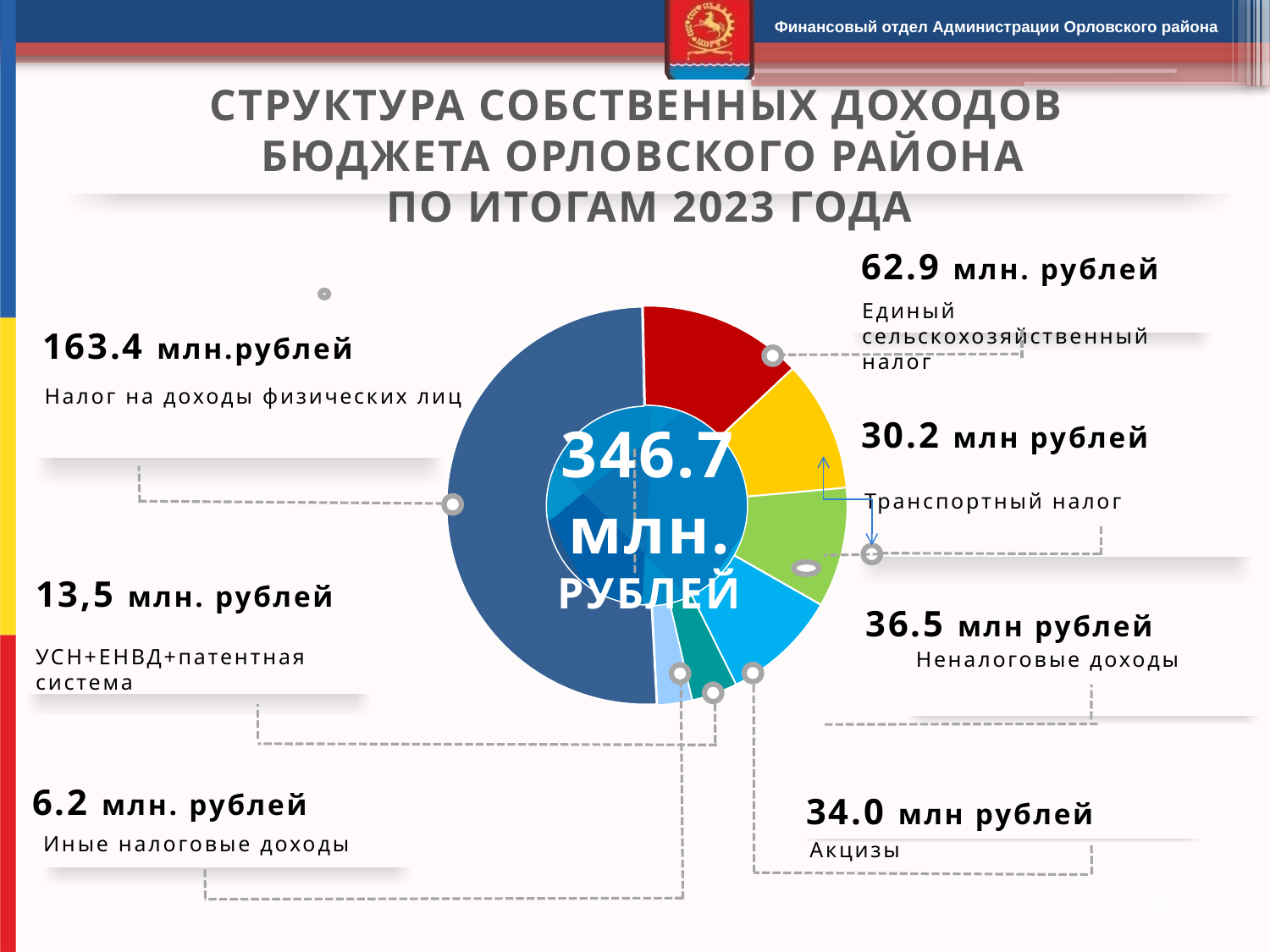
What total value is printed in the centre of the donut chart? 346.7 млн. рублей Which category is represented by the red segment of the chart? Единый сельскохозяйственный налог What type of chart is shown on the slide? Pie (donut) chart What is the value for Транспортный налог? 30.2 млн рублей What is the value for Акцизы? 34.0 млн рублей Which revenue category has the largest value? Налог на доходы физических лиц Which revenue category has the smallest value? Иные налоговые доходы Which is larger: Неналоговые доходы or Акцизы? Неналоговые доходы How many revenue categories are shown in the chart? 7 What is the value for Единый сельскохозяйственный налог? 62.9 млн. рублей What is the value for Налог на доходы физических лиц? 163.4 млн.рублей What is the difference between Налог на доходы физических лиц and Единый сельскохозяйственный налог? 100.5 млн. рублей